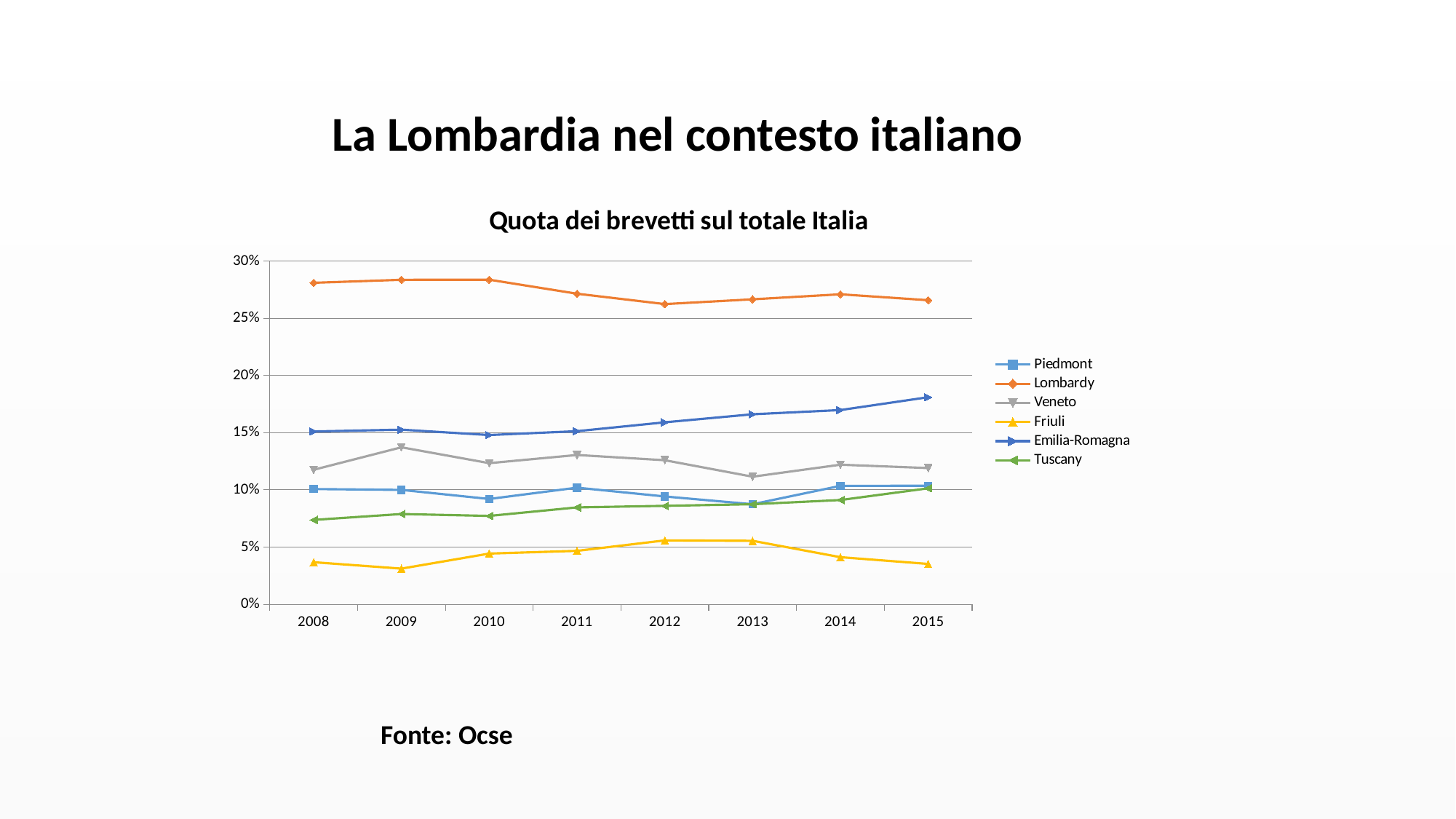
Is the value for Tuscany in 2008 greater or less than 10%? less How many series does the legend list? 6 Which region has the lowest share of patents in 2015? Friuli In 2009, which is larger: the value for Veneto or the value for Piedmont? Veneto Which region has the highest share of patents in 2015? Lombardy What is the title of the chart? Quota dei brevetti sul totale Italia What kind of chart is shown on the slide? line chart Is the value for Lombardy in 2008 greater or less than 25%? greater Is the value for Friuli in 2009 greater or less than 5%? less How many years are plotted along the x axis? 8 Does the share for Emilia-Romagna rise or fall from 2008 to 2015? rise